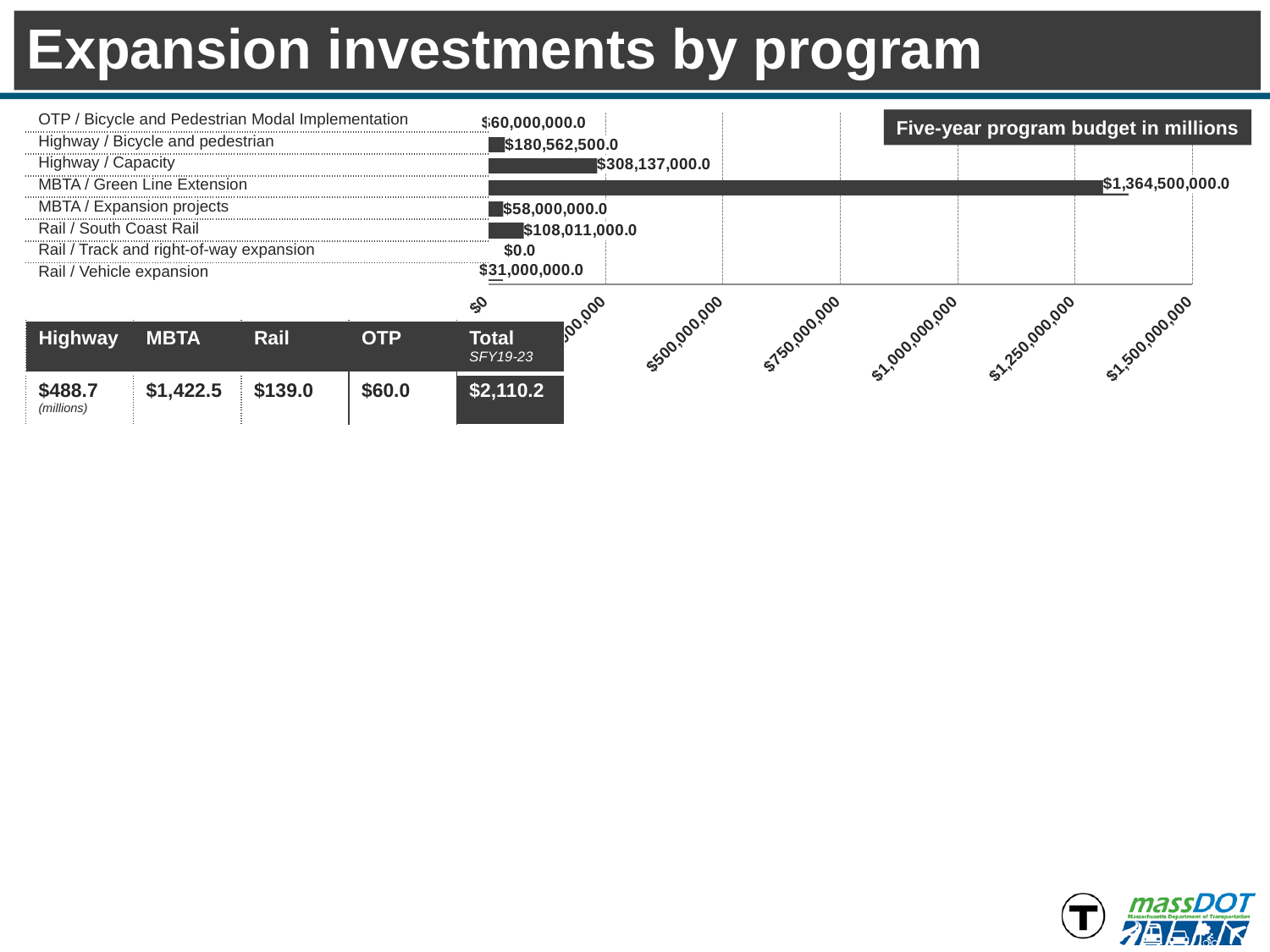
What is the value for MBTA / Green Line Extension? $1,364,500,000.0 How many categories are shown in the chart? 8 Which category has the highest value? MBTA / Green Line Extension What is the value for Rail / South Coast Rail? $108,011,000.0 Which is larger, Rail / South Coast Rail or MBTA / Expansion projects? Rail / South Coast Rail What is the difference between Highway / Capacity and Highway / Bicycle and pedestrian? $127,574,500.0 What is the value for Highway / Capacity? $308,137,000.0 What is the value for Rail / Vehicle expansion? $31,000,000.0 Which category has the lowest value? Rail / Track and right-of-way expansion What kind of chart is shown on the slide? bar chart What is the difference between OTP / Bicycle and Pedestrian Modal Implementation and MBTA / Expansion projects? $2,000,000.0 Is the value for MBTA / Green Line Extension greater or less than $1,250,000,000? greater